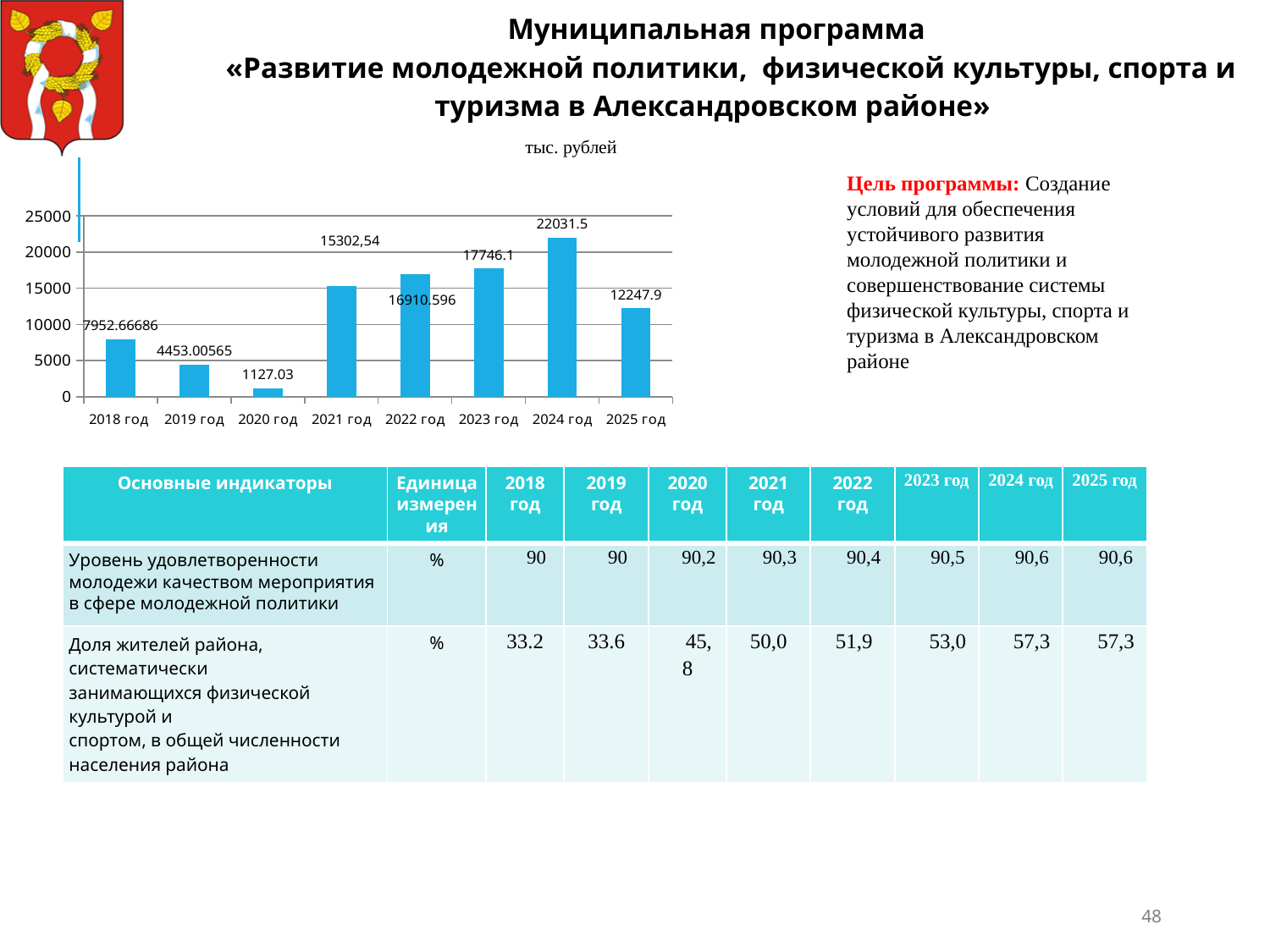
Is the value for 2018 год in the bar chart greater or less than 10000? less How many years are shown on the x axis of the bar chart? 8 What is the value for 2025 год in the bar chart? 12247.9 What is the value for 2018 год in the bar chart? 7952.66686 Do the values in the bar chart rise or fall from 2018 год to 2020 год? fall Which is larger in the bar chart, the value for 2022 год or the value for 2019 год? 2022 год What is the value for 2020 год in the bar chart? 1127.03 Which year has the highest value in the bar chart? 2024 год What is the difference between the values for 2024 год and 2025 год in the bar chart? 9783.6 Which year has the lowest value in the bar chart? 2020 год What is the value for 2024 год in the bar chart? 22031.5 What kind of chart is shown on the slide? bar chart